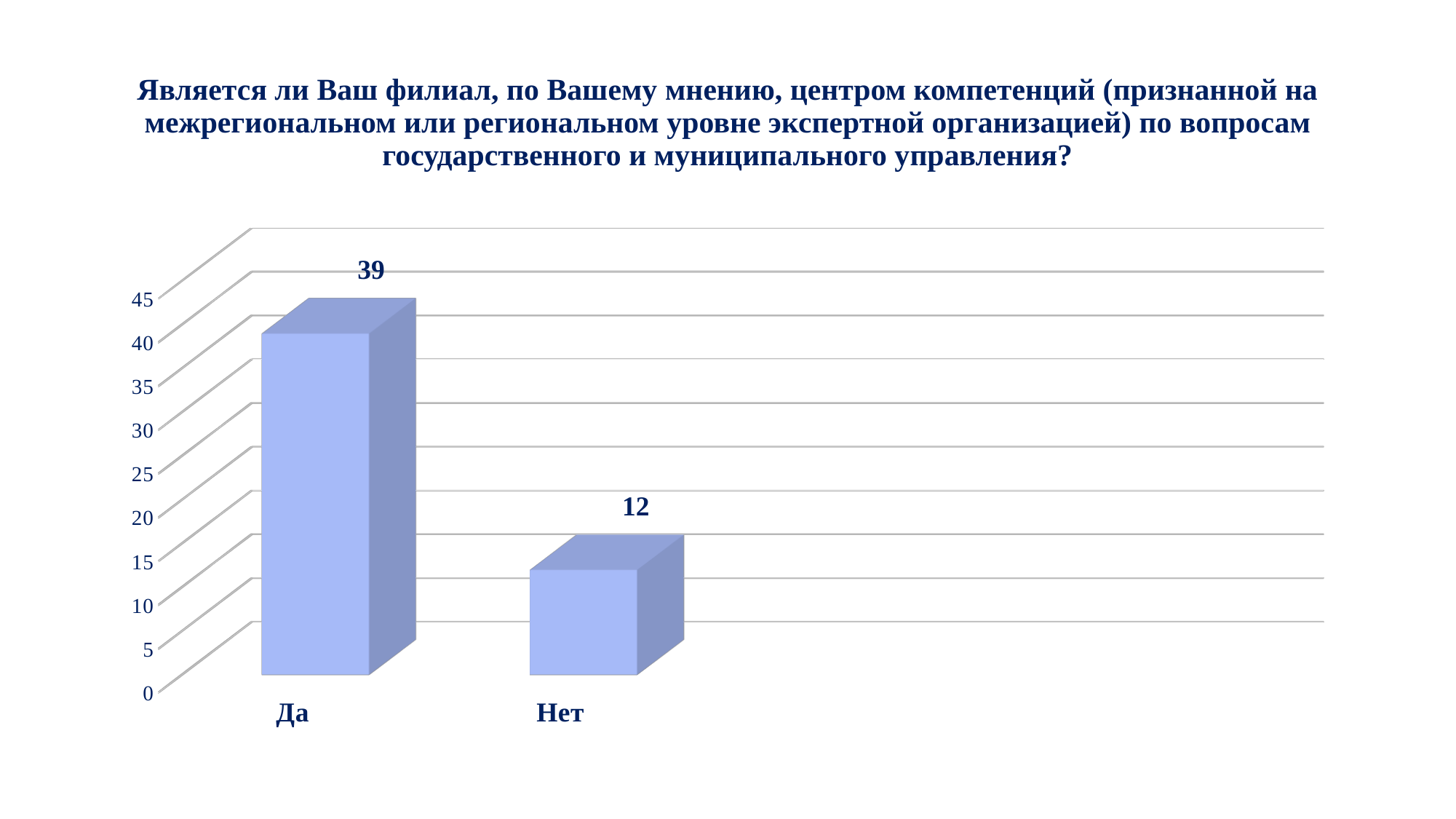
Is the value for "Да" greater or less than 30? greater What is the difference between the values for "Да" and "Нет"? 27 Which category has the lowest value? Нет What is the value for "Да"? 39 What kind of chart is shown on the slide? bar chart How many categories are shown on the x axis? 2 Which category has the highest value? Да What is the highest tick value shown on the vertical axis? 45 Is the value for "Нет" greater or less than 20? less What is the value for "Нет"? 12 What is the total of the values for "Да" and "Нет"? 51 Which is larger, the value for "Да" or the value for "Нет"? Да